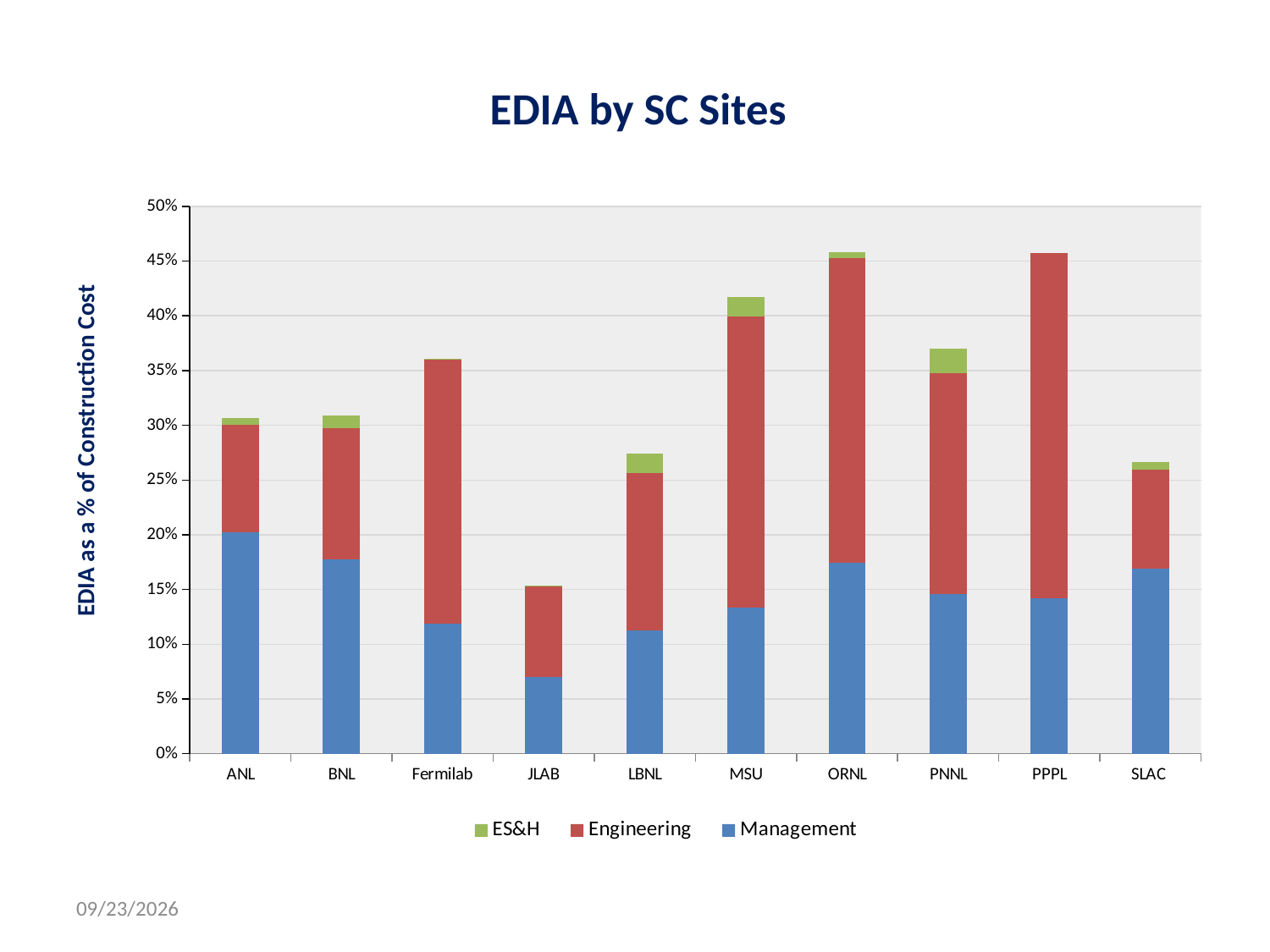
How many SC sites are shown on the x axis? 10 Which site has the larger total EDIA value, MSU or PNNL? MSU Is the total EDIA value for Fermilab greater or less than 35%? greater Which site has the lowest total EDIA as a % of construction cost? JLAB Is the total EDIA value for MSU greater or less than 40%? greater Is the total EDIA value for JLAB greater or less than 20%? less What is the title of the y axis? EDIA as a % of Construction Cost Which site has the largest Management segment? ANL Which site has the larger total EDIA value, Fermilab or LBNL? Fermilab What kind of chart is shown on the slide? Stacked bar chart How many series does the legend list? 3